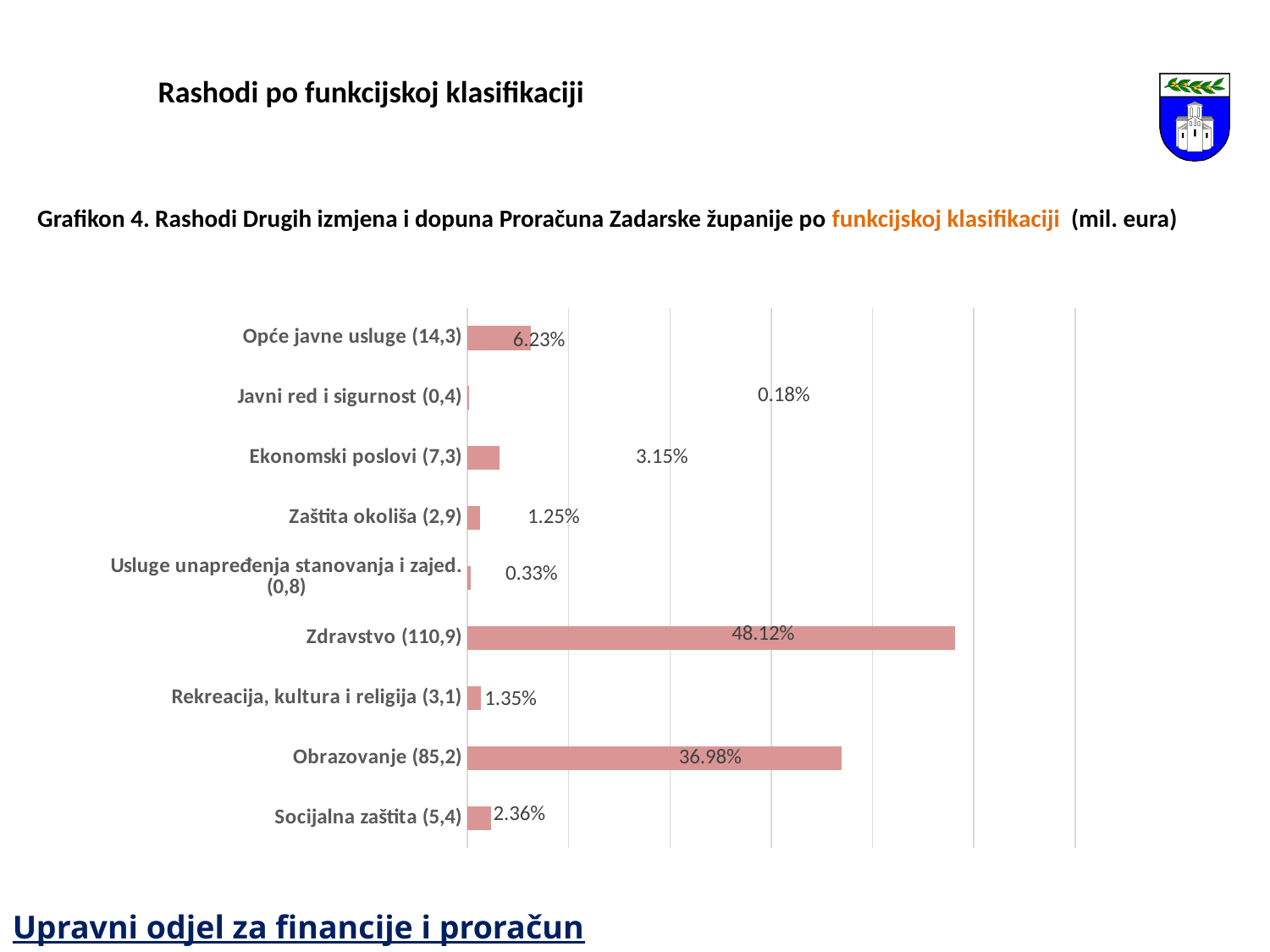
What percentage is shown for Zdravstvo (110,9)? 48.12% How many categories are shown in the chart? 9 What is the difference between Opće javne usluge (14,3) and Ekonomski poslovi (7,3)? 3.08% What type of chart is shown on the slide? Bar chart What is the data label for Javni red i sigurnost (0,4)? 0.18% What unit is stated in the chart title for the values in parentheses? mil. eura Which is larger, the share for Ekonomski poslovi (7,3) or for Zaštita okoliša (2,9)? Ekonomski poslovi (7,3) Which category has the highest share of expenditures? Zdravstvo (110,9) What is the difference in percentage points between Zdravstvo (110,9) and Obrazovanje (85,2)? 11.14% Which category has the lowest share of expenditures? Javni red i sigurnost (0,4) What percentage is shown for Obrazovanje (85,2)? 36.98% What percentage is shown for Socijalna zaštita (5,4)? 2.36%